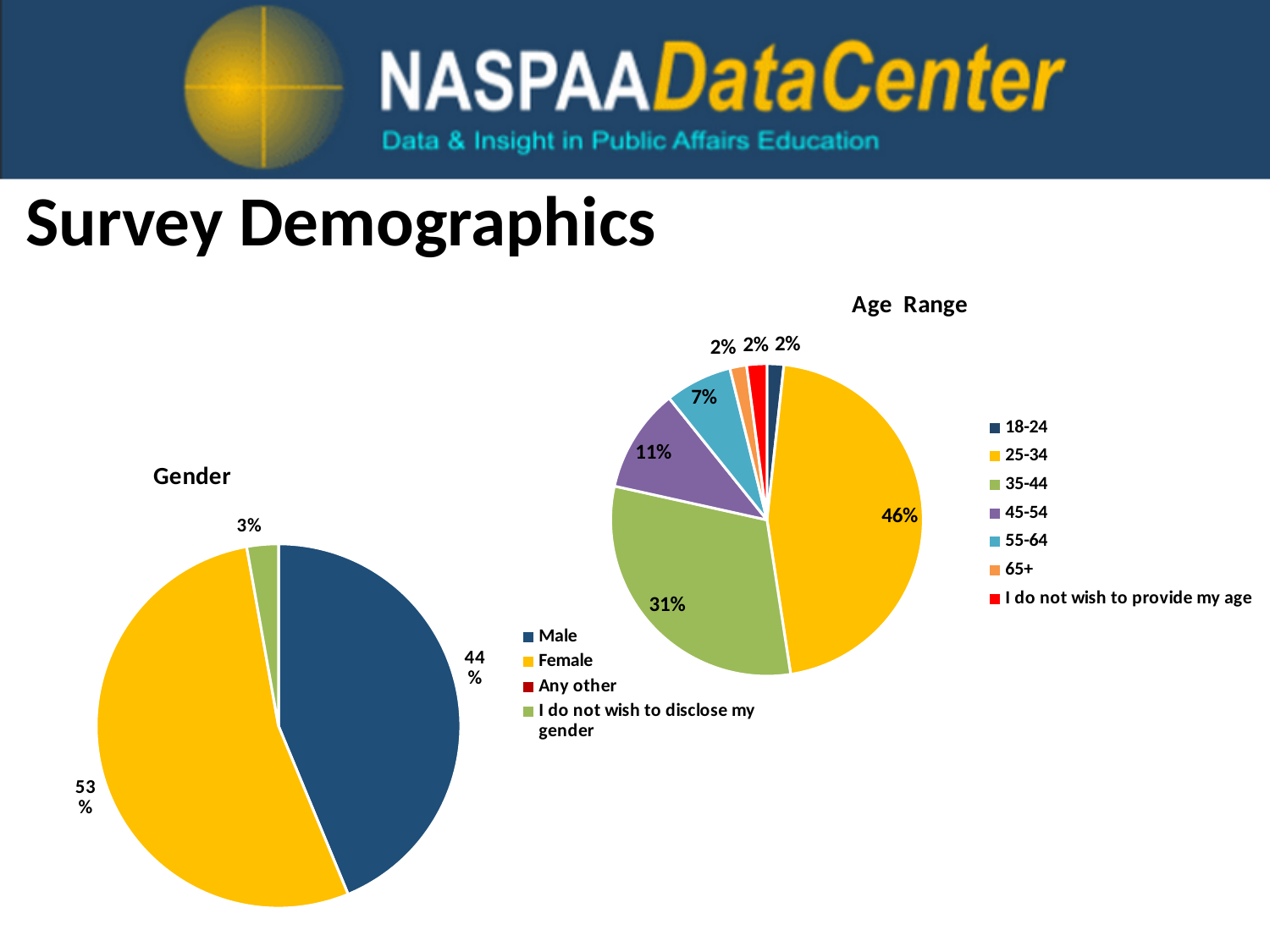
In the Age Range chart, how many categories does the legend list? 7 In the Age Range chart, what share of respondents are aged 55-64? 7% In the Gender chart, what share of respondents are Male? 44% In the Gender chart, what share of respondents are Female? 53% In the Gender chart, how many percentage points larger is the Female share than the Male share? 9 In the Age Range chart, which age group has the largest share? 25-34 In the Age Range chart, what share of respondents are aged 25-34? 46% In the Age Range chart, what share of respondents are aged 45-54? 11% In the Age Range chart, what share of respondents are aged 35-44? 31% In the Gender chart, what percentage of respondents did not wish to disclose their gender? 3% In the Gender chart, which category has the largest share? Female What type of chart is the Gender chart? Pie chart